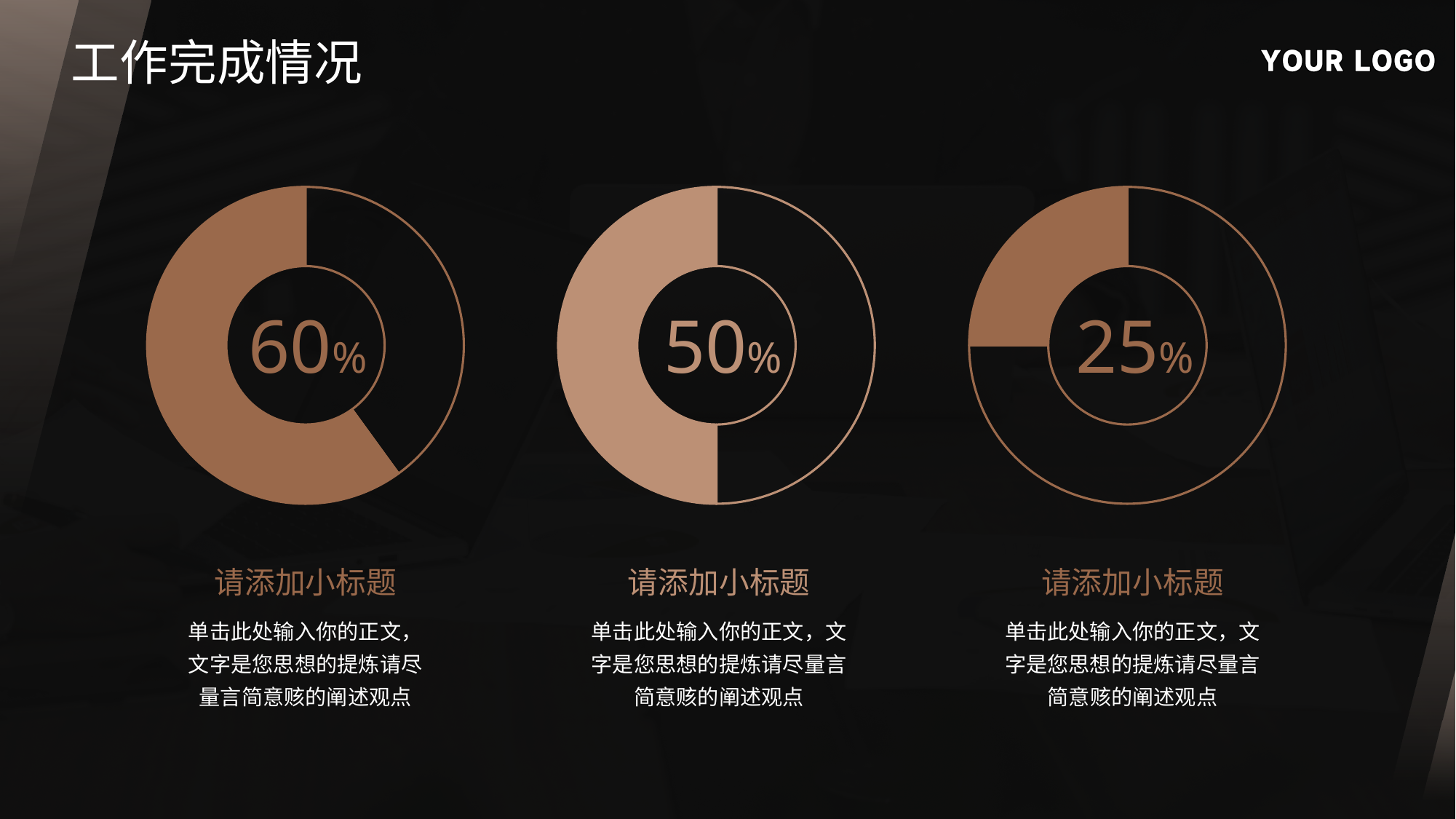
Which of the three donut charts shows the highest percentage? The left chart (60%) What value is shown in the centre of the middle donut chart? 50% What kind of chart is used to show the percentages on this slide? Donut chart How many donut charts are on the slide? 3 What value is shown in the centre of the right donut chart? 25% Which of the three donut charts shows the lowest percentage? The right chart (25%) What is the difference between the percentage in the left donut chart and the percentage in the right donut chart? 35% What is the title of the slide containing the three donut charts? 工作完成情况 What is the difference between the percentage in the middle donut chart and the percentage in the right donut chart? 25% Which is larger, the percentage in the left donut chart or the percentage in the middle donut chart? The left chart (60%) What colour is the filled portion of each donut chart? Brown (copper) What value is shown in the centre of the left donut chart? 60%